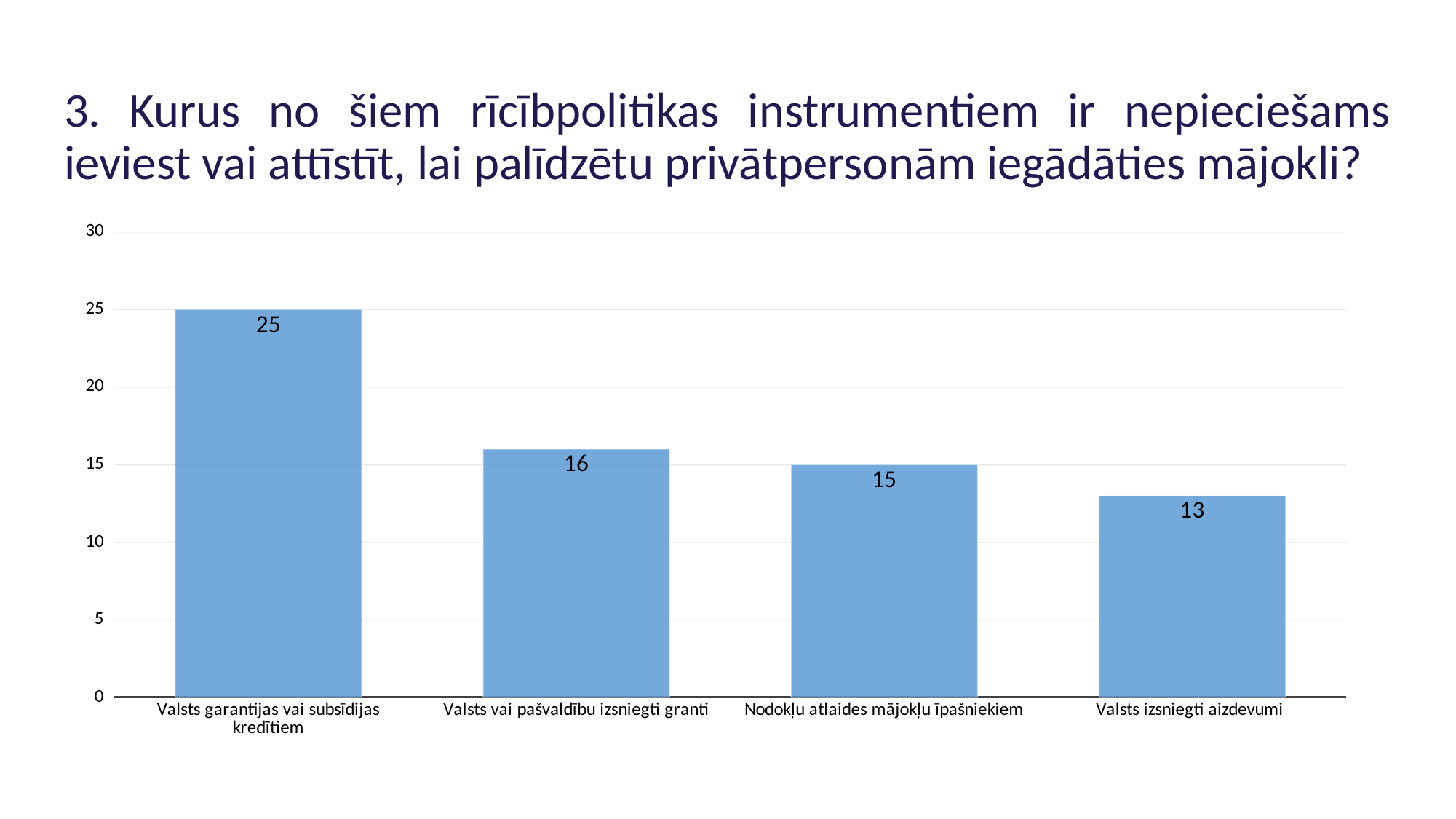
What is the value for "Valsts vai pašvaldību izsniegti granti"? 16 Is the value for "Valsts garantijas vai subsīdijas kredītiem" greater or less than 20? greater What is the difference between the values for "Valsts vai pašvaldību izsniegti granti" and "Nodokļu atlaides mājokļu īpašniekiem"? 1 What is the value for "Nodokļu atlaides mājokļu īpašniekiem"? 15 Which category has the lowest value? Valsts izsniegti aizdevumi How many categories are shown in the chart? 4 Which is larger: the value for "Valsts vai pašvaldību izsniegti granti" or for "Valsts izsniegti aizdevumi"? Valsts vai pašvaldību izsniegti granti What is the value for "Valsts izsniegti aizdevumi"? 13 What is the difference between the values for "Valsts garantijas vai subsīdijas kredītiem" and "Valsts izsniegti aizdevumi"? 12 Which category has the highest value? Valsts garantijas vai subsīdijas kredītiem What is the value for "Valsts garantijas vai subsīdijas kredītiem"? 25 What kind of chart is shown on the slide? bar chart